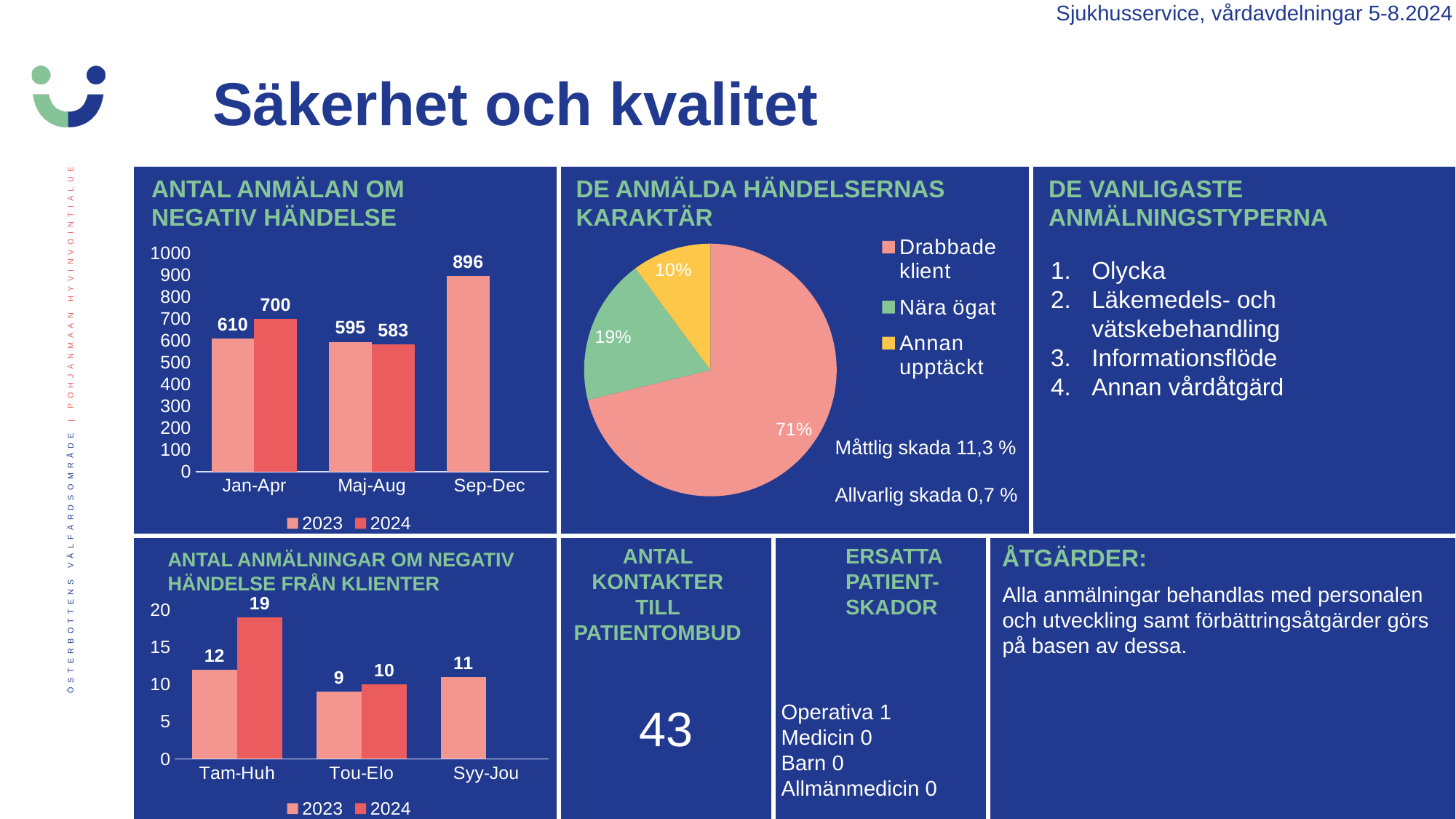
In the pie chart 'DE ANMÄLDA HÄNDELSERNAS KARAKTÄR', which category has the largest slice? Drabbade klient In the chart 'ANTAL ANMÄLAN OM NEGATIV HÄNDELSE', what is the difference between the 2023 and 2024 values for Maj-Aug? 12 In the chart 'ANTAL ANMÄLAN OM NEGATIV HÄNDELSE', what is the value for 2024 in Jan-Apr? 700 In the pie chart 'DE ANMÄLDA HÄNDELSERNAS KARAKTÄR', which category has the smallest slice? Annan upptäckt In the chart 'ANTAL ANMÄLNINGAR OM NEGATIV HÄNDELSE FRÅN KLIENTER', which is larger for Tou-Elo, the 2023 value or the 2024 value? 2024 In the chart 'ANTAL ANMÄLNINGAR OM NEGATIV HÄNDELSE FRÅN KLIENTER', what is the value for 2024 in Tam-Huh? 19 In the chart 'ANTAL ANMÄLAN OM NEGATIV HÄNDELSE', what is the value for 2023 in Sep-Dec? 896 What kind of chart is 'DE ANMÄLDA HÄNDELSERNAS KARAKTÄR'? Pie chart In the chart 'ANTAL ANMÄLAN OM NEGATIV HÄNDELSE', which period has the highest 2023 value? Sep-Dec In the chart 'ANTAL ANMÄLAN OM NEGATIV HÄNDELSE', how many series does the legend list? 2 In the chart 'ANTAL ANMÄLNINGAR OM NEGATIV HÄNDELSE FRÅN KLIENTER', how many categories are shown on the x axis? 3 In the pie chart 'DE ANMÄLDA HÄNDELSERNAS KARAKTÄR', what share does 'Nära ögat' have? 19%